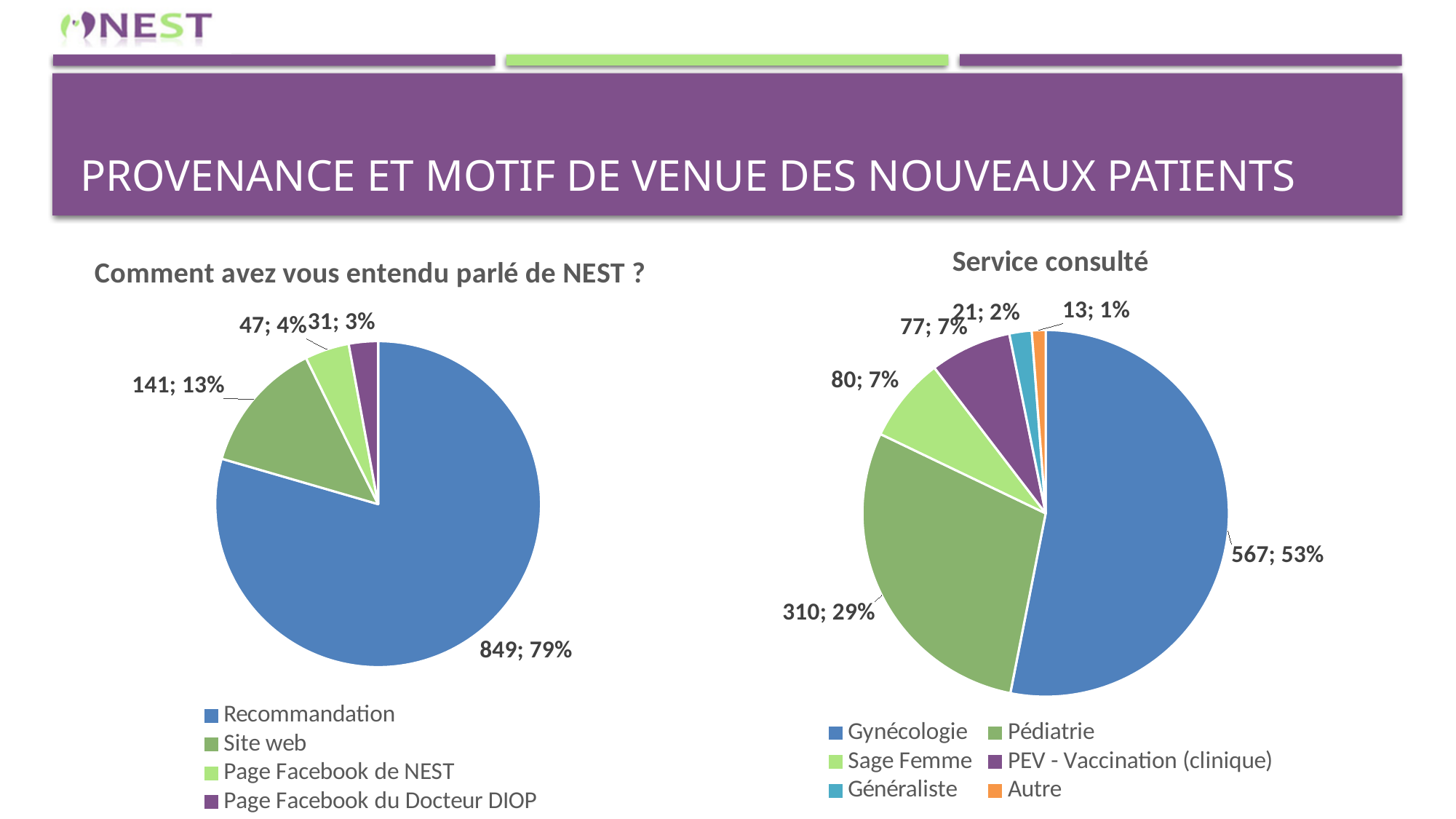
What type of chart is 'Service consulté'? Pie chart In the chart 'Service consulté', which is larger: Sage Femme or Généraliste? Sage Femme In the chart 'Service consulté', how many categories does the legend list? 6 In the chart 'Comment avez vous entendu parlé de NEST ?', what is the count for Recommandation? 849 In the chart 'Service consulté', what share of the pie does Gynécologie represent? 53% In the chart 'Service consulté', which category is the smallest? Autre In the chart 'Comment avez vous entendu parlé de NEST ?', what is the difference between the counts for Site web and Page Facebook de NEST? 94 In the chart 'Comment avez vous entendu parlé de NEST ?', how many categories does the legend list? 4 In the chart 'Service consulté', which category is the largest? Gynécologie In the chart 'Comment avez vous entendu parlé de NEST ?', which category is the smallest? Page Facebook du Docteur DIOP In the chart 'Service consulté', what is the count for Pédiatrie? 310 In the chart 'Comment avez vous entendu parlé de NEST ?', what share of the pie does Site web represent? 13%